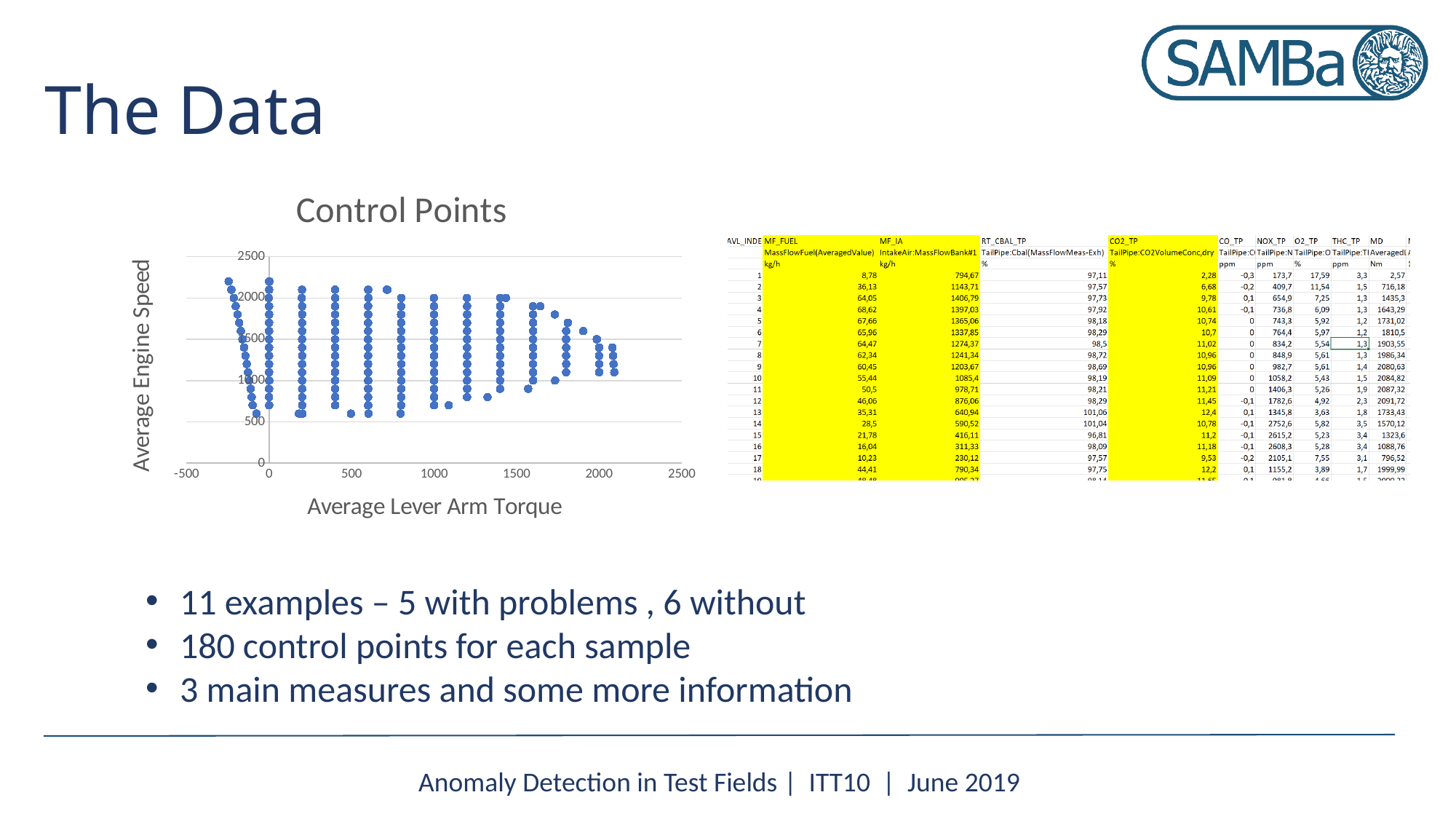
In the "Control Points" chart, are the engine speeds of the points at a torque of about 2000 greater or less than 2000? less What kind of chart is the "Control Points" chart? scatter chart What is the title of the chart on the left of the slide? Control Points What is the lowest tick value shown on the horizontal axis of the "Control Points" chart? -500 In the "Control Points" chart, is the smallest Average Lever Arm Torque plotted greater or less than 0? less What is the label of the horizontal axis of the "Control Points" chart? Average Lever Arm Torque In the "Control Points" chart, does the spread of Average Engine Speed values widen or narrow as Average Lever Arm Torque increases? narrow In the "Control Points" chart, is the lowest Average Engine Speed plotted greater or less than 500? greater What is the highest tick value shown on the vertical axis of the "Control Points" chart? 2500